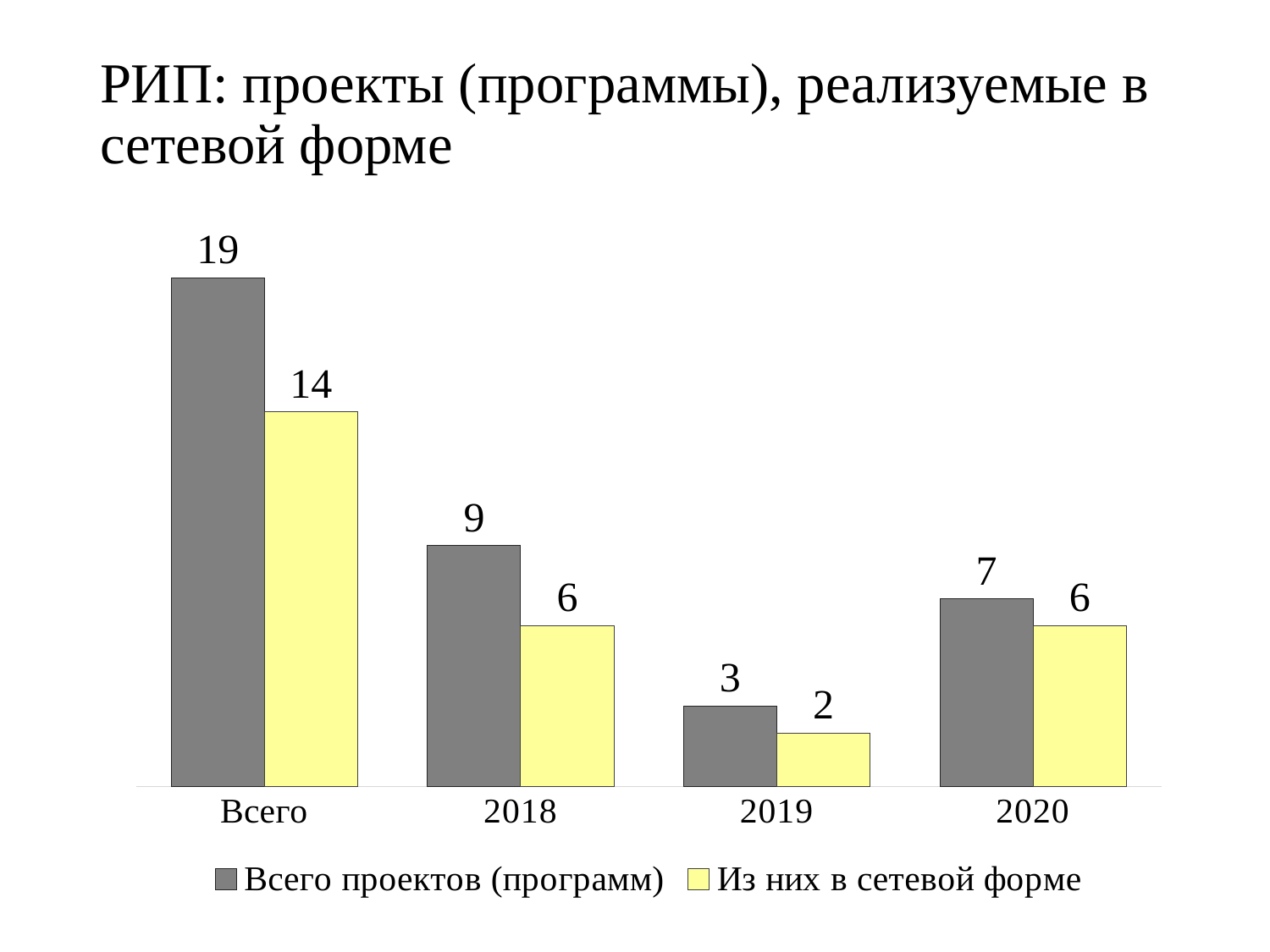
What is the difference between "Всего проектов (программ)" and "Из них в сетевой форме" in the "Всего" category? 5 What is the value of "Из них в сетевой форме" for 2019? 2 What is the value of "Из них в сетевой форме" for the "Всего" category? 14 Which year (2018, 2019 or 2020) has the lowest value for "Всего проектов (программ)"? 2019 Which is larger: "Всего проектов (программ)" for 2018 or for 2020? 2018 Which colour represents the series "Из них в сетевой форме"? Yellow How many series does the legend list? 2 Which category has the highest value for "Из них в сетевой форме"? Всего How many categories are shown on the x axis? 4 What is the value of "Всего проектов (программ)" for 2018? 9 What is the difference between "Всего проектов (программ)" and "Из них в сетевой форме" for 2020? 1 What kind of chart is shown on the slide? Bar chart